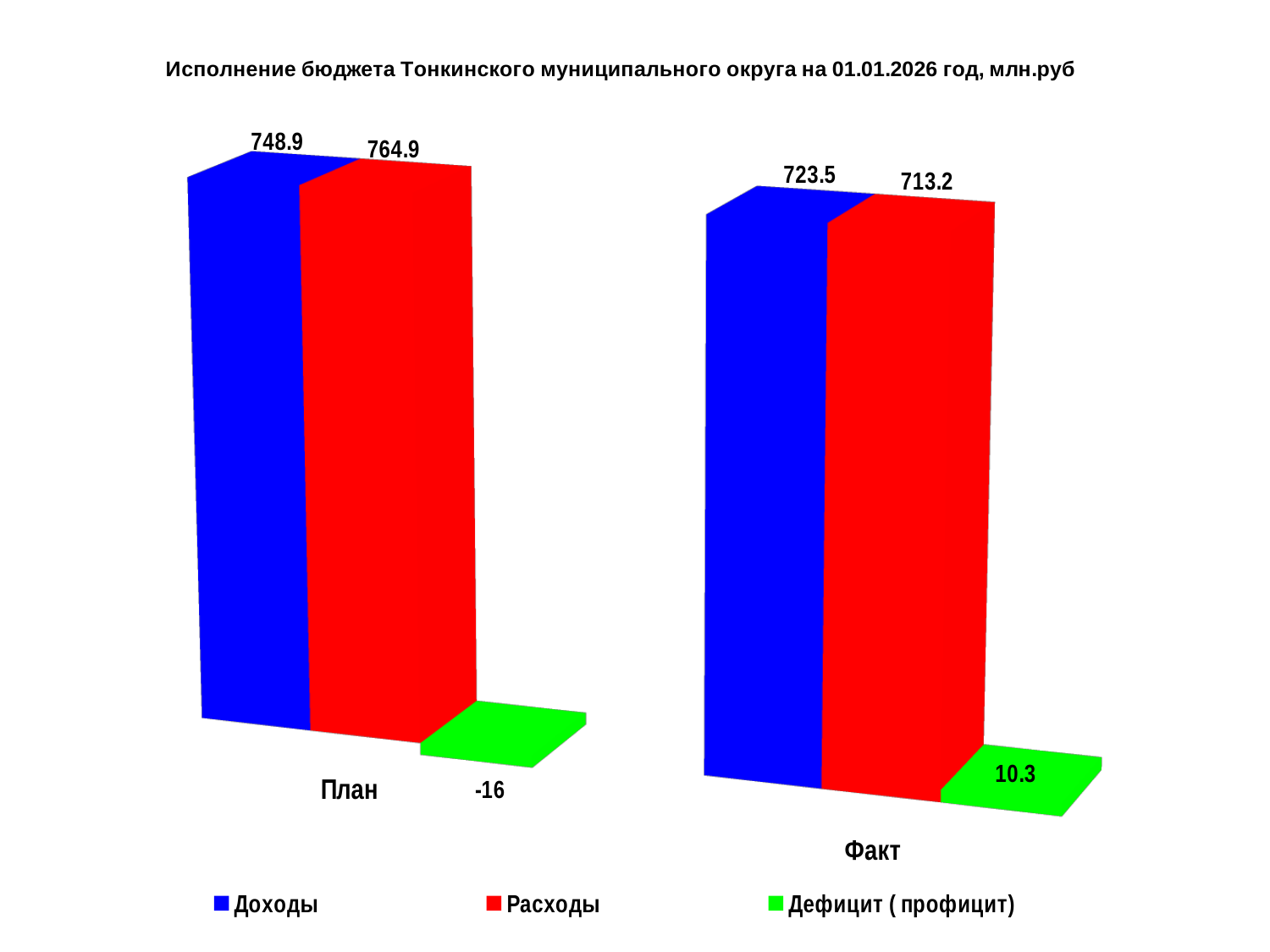
What is the difference between Расходы and Доходы for План? 16 How many series does the legend list? 3 Which is larger for План: Доходы or Расходы? Расходы What is the value of Расходы for Факт? 713.2 What is the difference between Доходы for План and Доходы for Факт? 25.4 Which is larger for Факт: Доходы or Расходы? Доходы What is the value of Доходы for План? 748.9 Which colour represents Расходы in the legend? Red What is the value of Дефицит (профицит) for Факт? 10.3 What kind of chart is shown on the slide? Bar chart How many categories are shown on the x axis? 2 What is the value of Дефицит (профицит) for План? -16